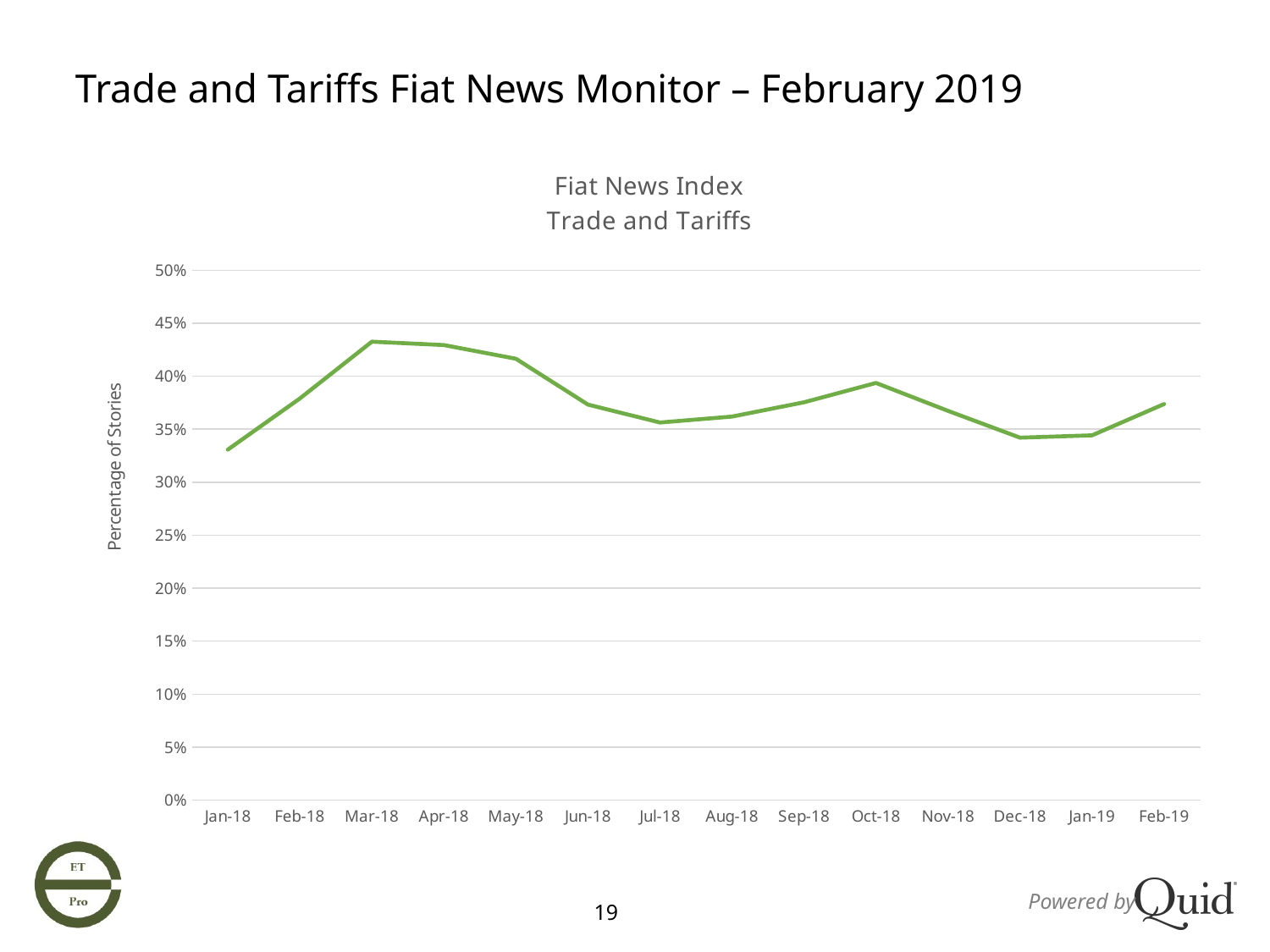
Is the value for Jul-18 greater or less than 40%? less What is the label on the vertical axis? Percentage of Stories Is the value for Mar-18 greater or less than 40%? greater Is the value for Dec-18 greater or less than 35%? less Which is higher, the value for Oct-18 or the value for Dec-18? Oct-18 What kind of chart is shown on the slide? line chart Which month has the lowest percentage of stories? Jan-18 Does the line rise or fall from Jan-18 to Mar-18? rise How many monthly data points are plotted on the chart? 14 Which is higher, the value for Mar-18 or the value for Jan-18? Mar-18